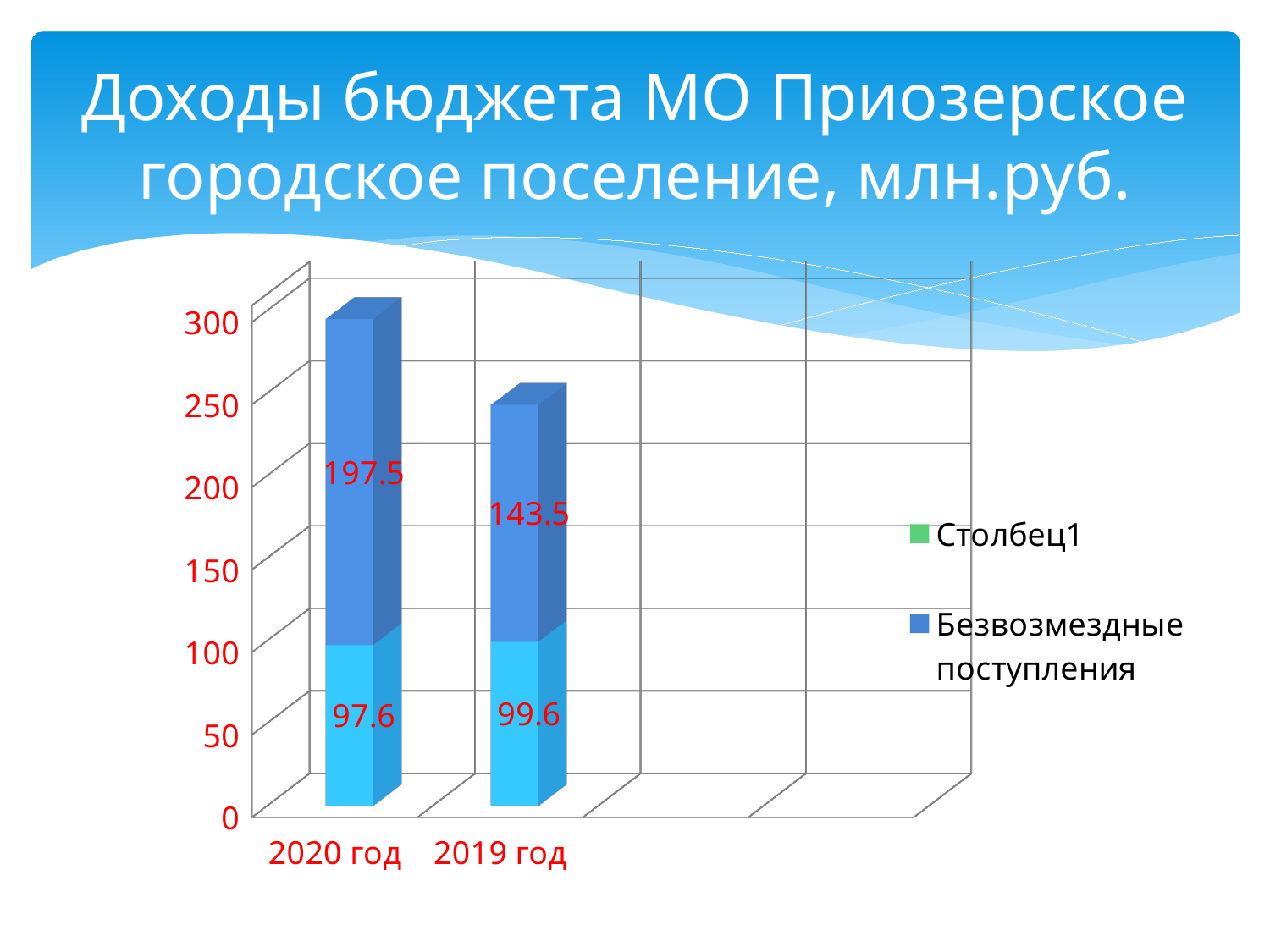
What is the total of the stacked bar for 2019 год? 243.1 How many categories are shown on the x axis? 2 Which year has the larger value of Безвозмездные поступления, 2020 год or 2019 год? 2020 год What is the value of Безвозмездные поступления for 2020 год? 197.5 By how much does Безвозмездные поступления for 2020 год exceed that for 2019 год? 54 What is the total of the stacked bar for 2020 год? 295.1 What kind of chart is shown on the slide? bar chart Which year has the larger light blue bottom segment, 2020 год or 2019 год? 2019 год What is the value of the light blue bottom segment of the bar for 2020 год? 97.6 What is the value of the light blue bottom segment of the bar for 2019 год? 99.6 How many series does the legend list? 2 What is the value of Безвозмездные поступления for 2019 год? 143.5